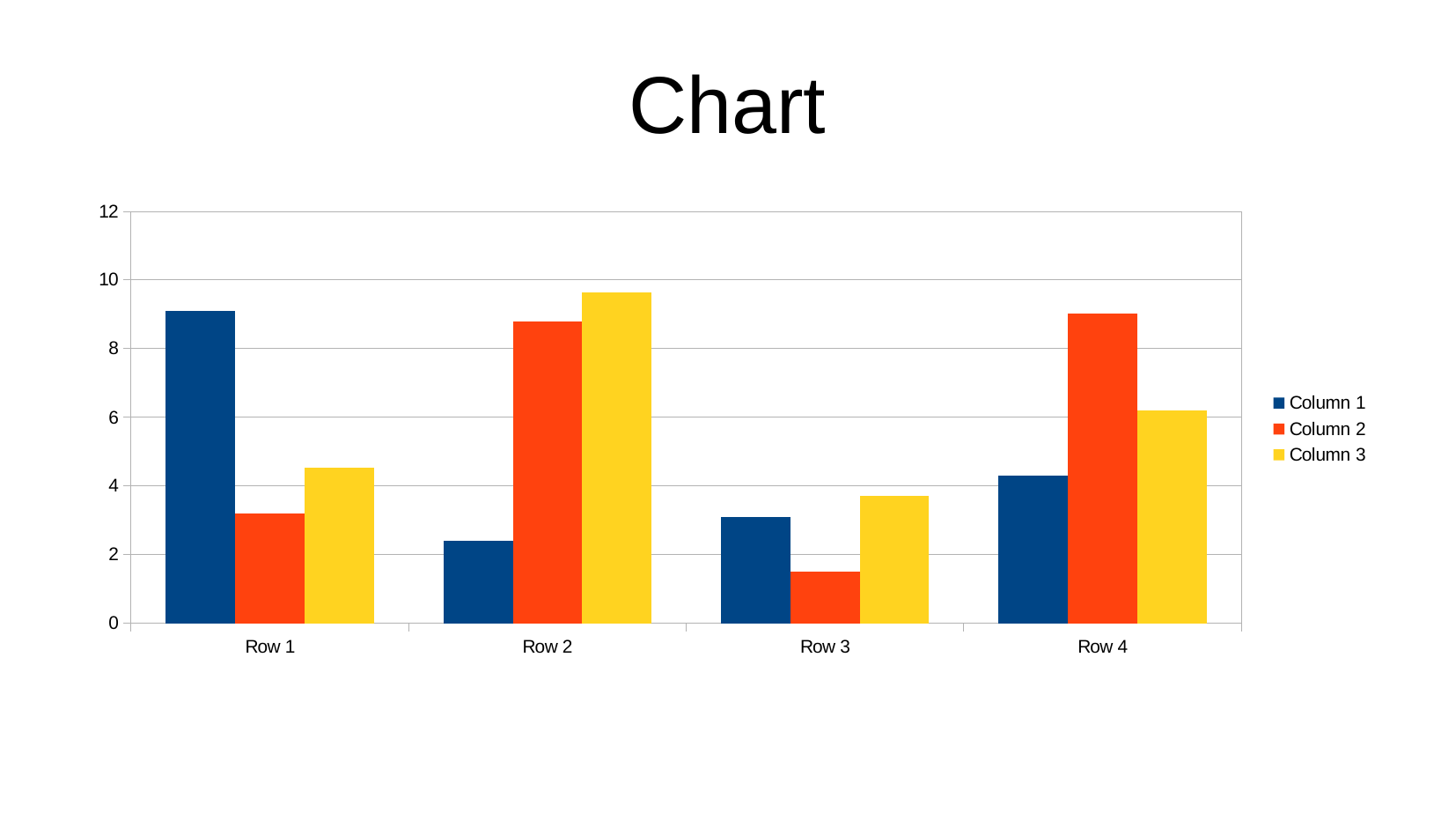
How many categories are shown on the x axis? 4 How many series does the legend list? 3 Which category has the highest value for Column 3? Row 2 Which category has the highest value for Column 1? Row 1 Which category has the lowest value for Column 2? Row 3 Is the value for Column 3 in Row 4 greater or less than 8? less What is the title of the chart? Chart What kind of chart is shown on the slide? bar chart In Row 2, which is larger, Column 2 or Column 3? Column 3 Is the value for Column 2 in Row 3 greater or less than 2? less Which category has the lowest value for Column 1? Row 2 Is the value for Column 1 in Row 1 greater or less than 8? greater